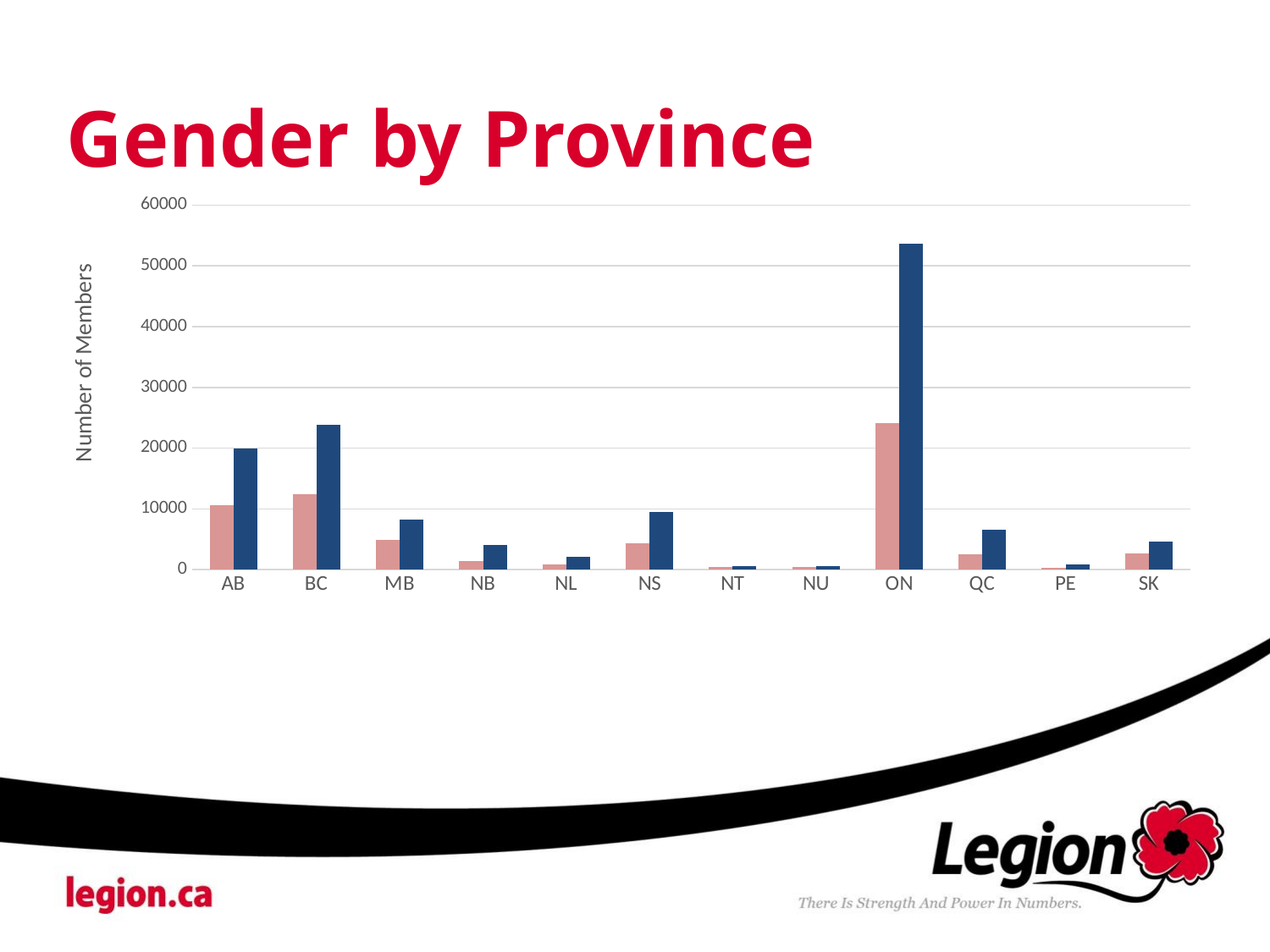
What is the title of the chart on the slide? Gender by Province For ON, which bar is larger, the pink bar or the blue bar? the blue bar Which is larger, the blue bar for ON or the blue bar for BC? ON Is the value of the blue bar for MB greater or less than 10000? less Is the value of the blue bar for QC greater or less than 10000? less What is the label on the vertical axis of the chart? Number of Members Is the value of the pink bar for ON greater or less than 20000? greater Which province has the tallest blue bar in the chart? ON How many provinces or territories are shown on the x axis of the chart? 12 What kind of chart is shown on the slide? bar chart